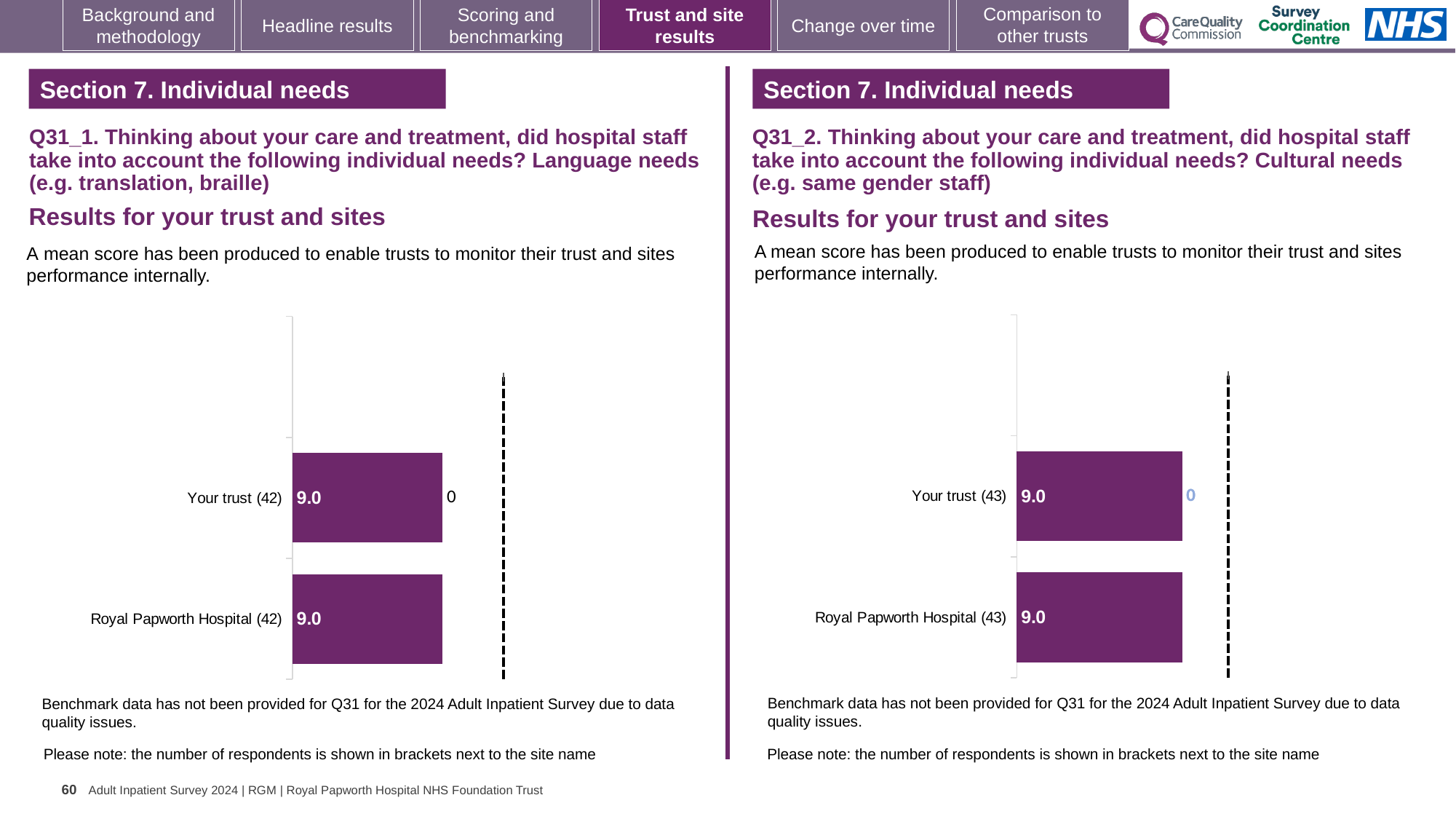
In the left chart (Q31_1, Language needs), how many respondents are shown in brackets next to Royal Papworth Hospital? 42 In the left chart (Q31_1, Language needs), what is the value for Your trust? 9.0 In the left chart (Q31_1, Language needs), what is the difference between the value for Your trust and the value for Royal Papworth Hospital? 0.0 In the right chart (Q31_2, Cultural needs), what is the difference between the value for Your trust and the value for Royal Papworth Hospital? 0.0 In the right chart (Q31_2, Cultural needs), what is the value for Your trust? 9.0 What kind of chart is used for the Q31_1 Language needs results on the left? Bar chart How many bars are plotted in the left chart (Q31_1, Language needs)? 2 How many bars are plotted in the right chart (Q31_2, Cultural needs)? 2 In the right chart (Q31_2, Cultural needs), how many respondents are shown in brackets next to Your trust? 43 In the left chart (Q31_1, Language needs), what is the value for Royal Papworth Hospital? 9.0 What kind of chart is used for the Q31_2 Cultural needs results on the right? Bar chart In the right chart (Q31_2, Cultural needs), what is the value for Royal Papworth Hospital? 9.0